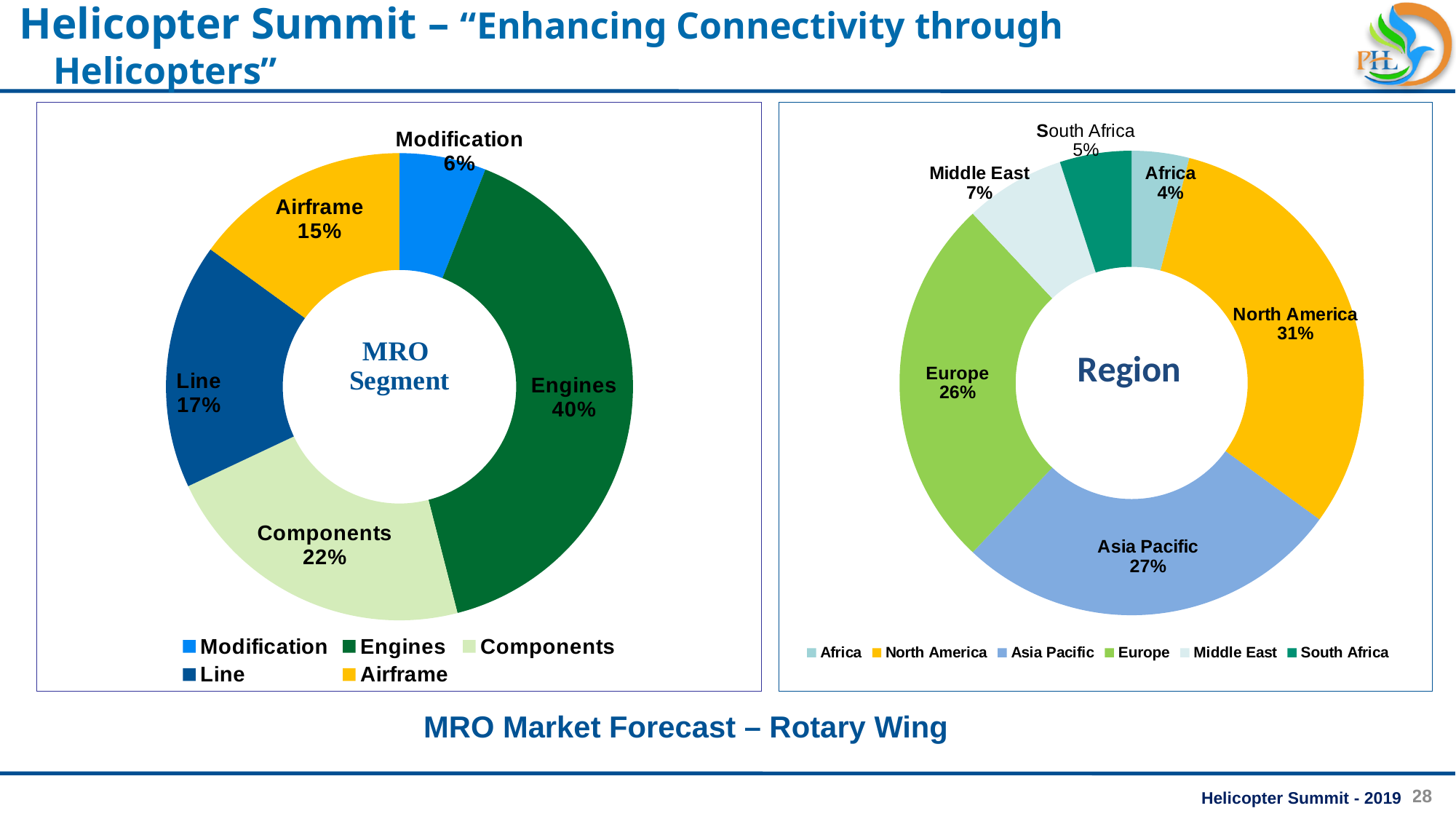
In the Region chart, which region has the smallest share? Africa In the MRO Segment chart, what share does Engines have? 40% In the MRO Segment chart, what is the difference between the Components share and the Line share? 5% In the MRO Segment chart, how many segments are shown? 5 In the Region chart, what share does North America have? 31% In the MRO Segment chart, which is larger, Airframe or Line? Line In the Region chart, which region has the largest share? North America In the Region chart, how many regions does the legend list? 6 In the Region chart, what is the difference between the Asia Pacific share and the Europe share? 1% What kind of chart is the Region chart? Pie chart (doughnut) In the MRO Segment chart, which segment has the largest share? Engines In the MRO Segment chart, which segment has the smallest share? Modification